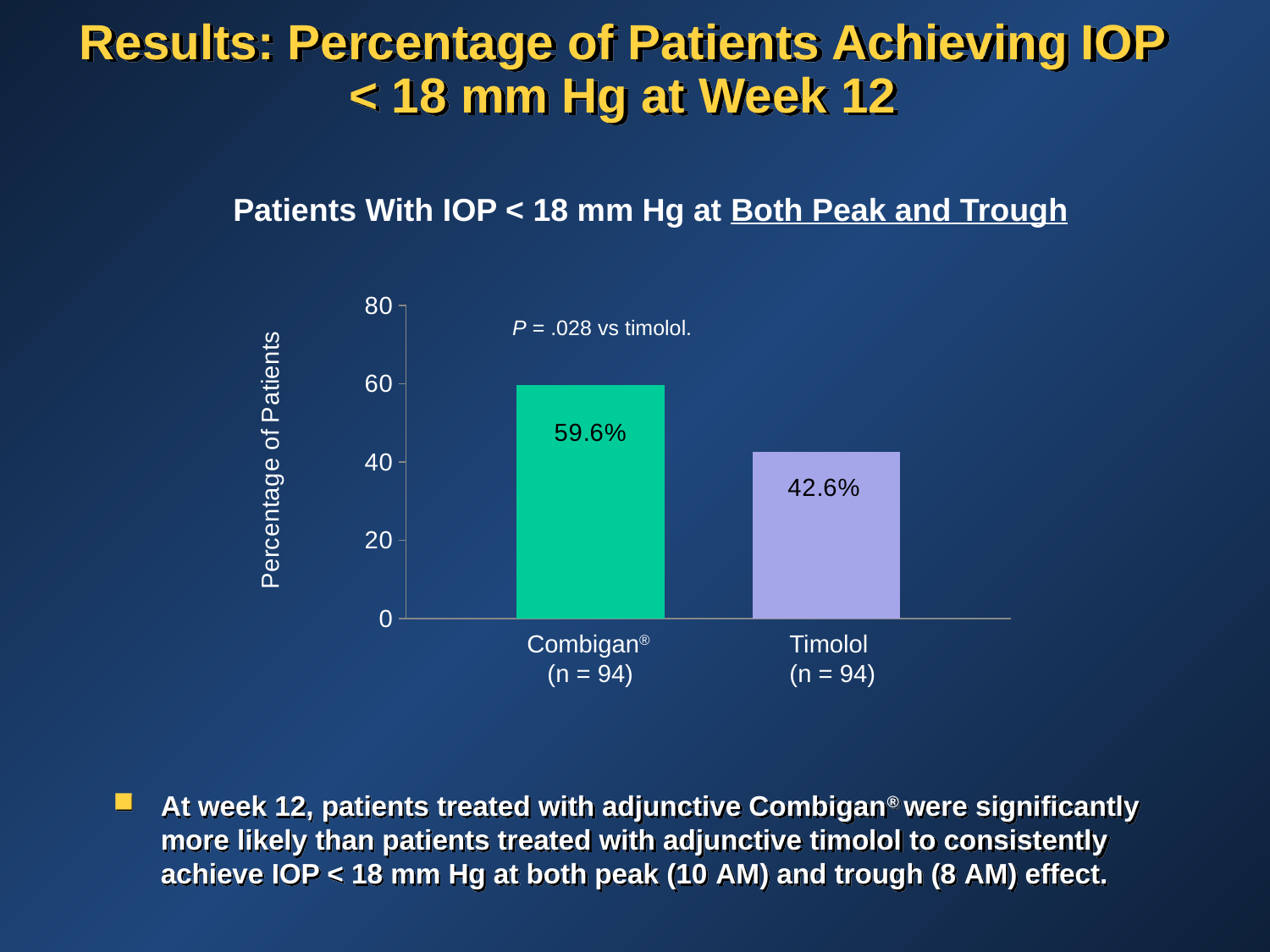
Is the value for Timolol greater or less than 60? less What is the label of the y-axis? Percentage of Patients How many patients were in the Timolol group according to the x-axis label? n = 94 What percentage of patients in the Timolol group achieved IOP < 18 mm Hg at both peak and trough? 42.6% Which treatment group has the higher percentage of patients with IOP < 18 mm Hg at both peak and trough? Combigan Which treatment group has the lower percentage of patients with IOP < 18 mm Hg at both peak and trough? Timolol What type of chart is shown on the slide? Bar chart How many treatment groups are shown in the chart? 2 What is the difference in percentage points between the Combigan and Timolol bars? 17 percentage points Is the value for Combigan greater or less than 40? greater What P value is shown on the chart for Combigan vs timolol? P = .028 What percentage of patients in the Combigan group achieved IOP < 18 mm Hg at both peak and trough? 59.6%